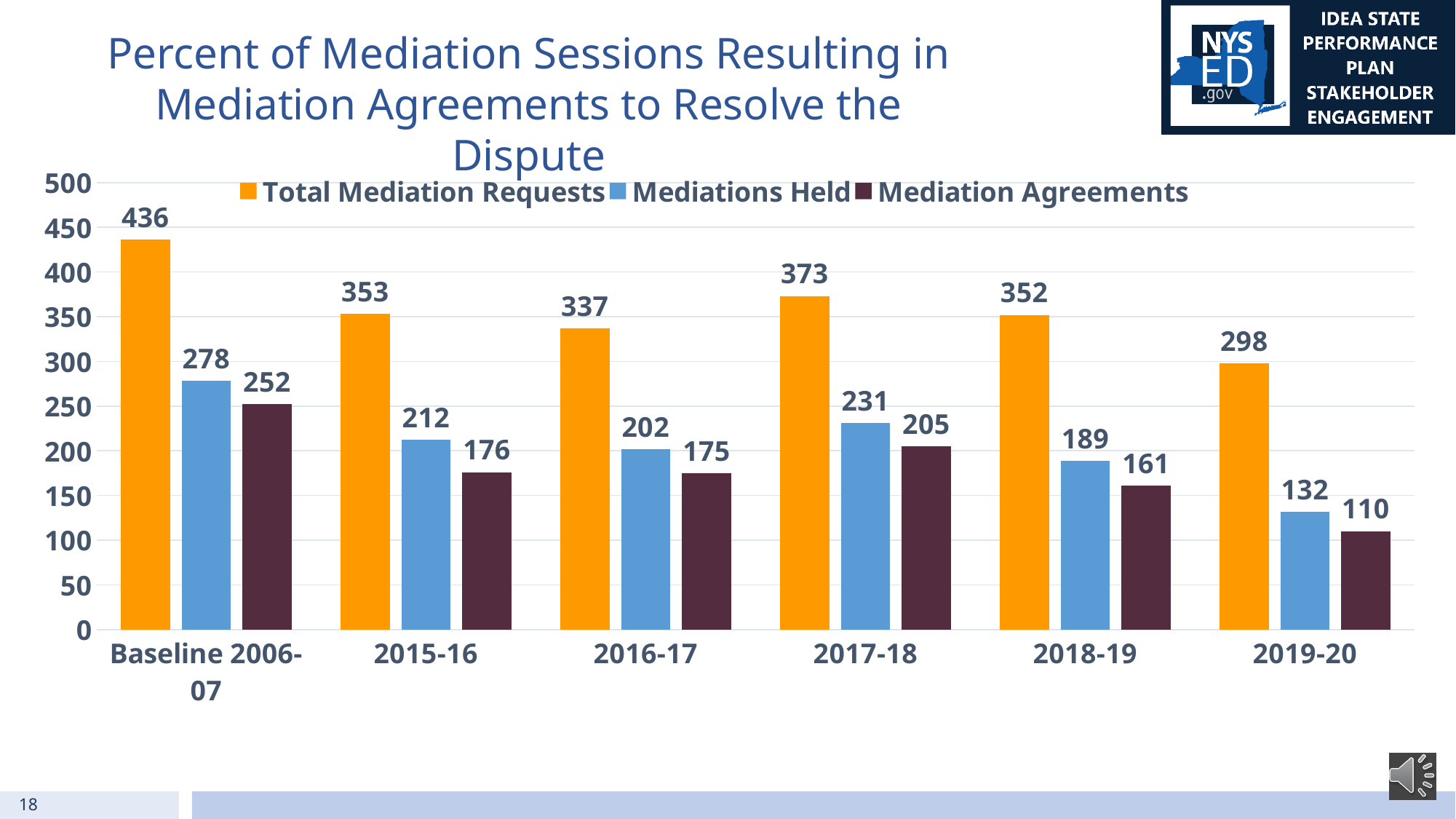
What is the value of Mediations Held for 2015-16? 212 Is the value of Total Mediation Requests for 2019-20 greater or less than 300? less How many series does the legend list? 3 What is the difference between Total Mediation Requests and Mediations Held for 2018-19? 163 Which is larger: Mediation Agreements for 2017-18 or Mediation Agreements for 2016-17? 2017-18 How many categories are shown on the x axis? 6 Which category has the lowest value for Mediations Held? 2019-20 What kind of chart is shown on the slide? bar chart What is the value of Mediation Agreements for 2019-20? 110 Which series is shown in orange? Total Mediation Requests What is the value of Total Mediation Requests for 2017-18? 373 Which category has the highest value for Total Mediation Requests? Baseline 2006-07